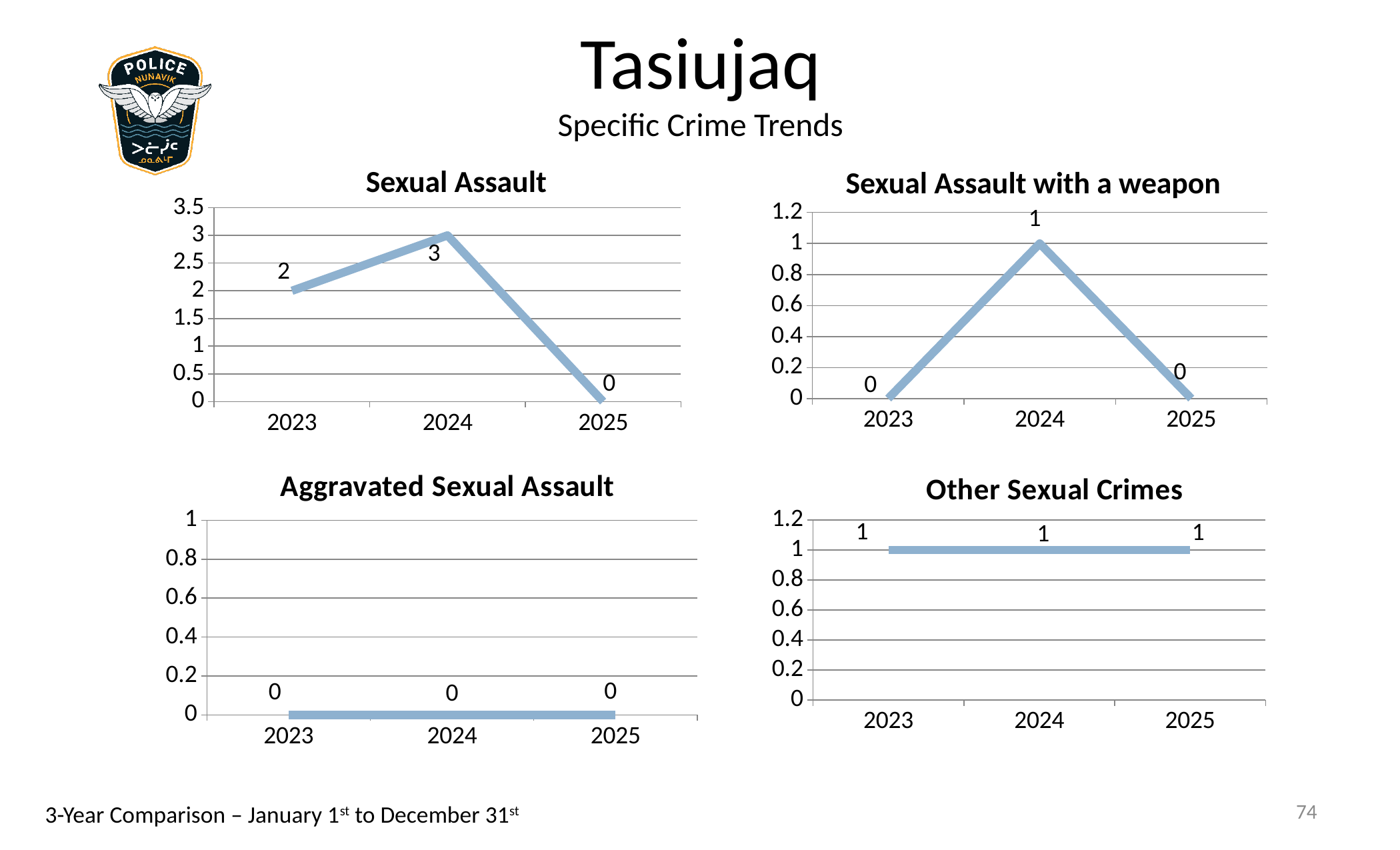
In the Sexual Assault chart, which year has the highest value? 2024 In the Sexual Assault chart, what is the value for 2024? 3 In the Sexual Assault chart, is the value for 2023 greater or less than 1.5? greater How many years are plotted in the Sexual Assault chart? 3 In the Other Sexual Crimes chart, what is the value for 2023? 1 In the Sexual Assault with a weapon chart, what is the value for 2024? 1 In the Other Sexual Crimes chart, do the values rise, fall, or stay flat from 2023 to 2025? stay flat In the Sexual Assault with a weapon chart, is the value for 2024 larger than the value for 2025? Yes In the Aggravated Sexual Assault chart, what is the value for 2025? 0 What kind of chart is the Sexual Assault with a weapon chart? line chart In the Sexual Assault with a weapon chart, which year has the highest value? 2024 In the Sexual Assault chart, what is the difference between the 2024 and 2023 values? 1